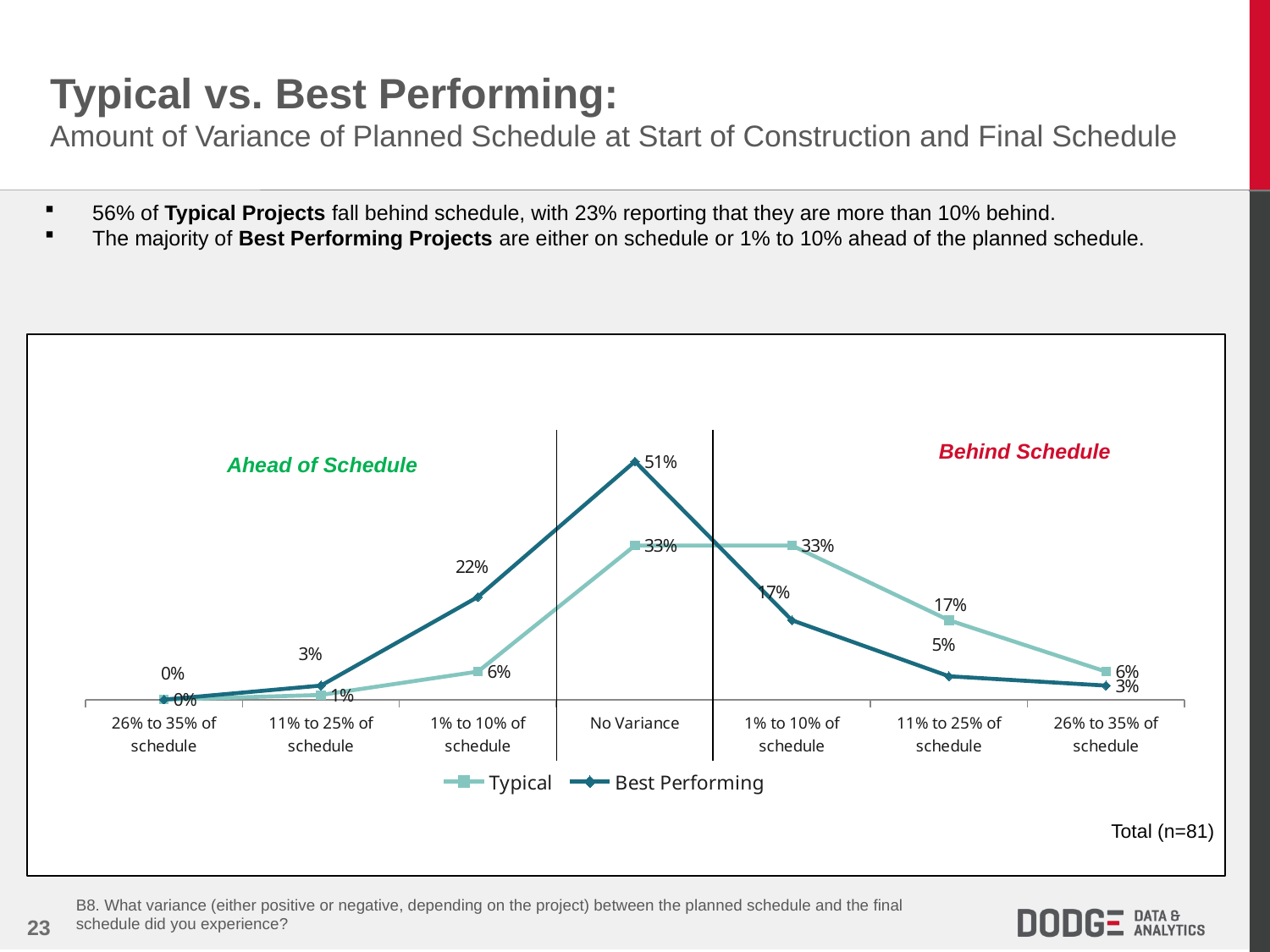
At which category does the Best Performing series reach its highest value? No Variance What kind of chart is shown on the slide? Line chart What is the Best Performing value for 1% to 10% of schedule on the Ahead of Schedule side? 22% What is the Best Performing value at No Variance? 51% What is the difference between the Best Performing and Typical values at No Variance? 18 percentage points What is the Typical value for 11% to 25% of schedule on the Behind Schedule side? 17% What are the two series named in the legend? Typical and Best Performing How many categories are shown on the x axis? 7 What is the Typical value at No Variance? 33% How many series does the legend list? 2 Does the Best Performing series rise or fall from No Variance to 26% to 35% of schedule on the Behind Schedule side? Fall For 1% to 10% of schedule on the Behind Schedule side, which series has the higher value, Typical or Best Performing? Typical